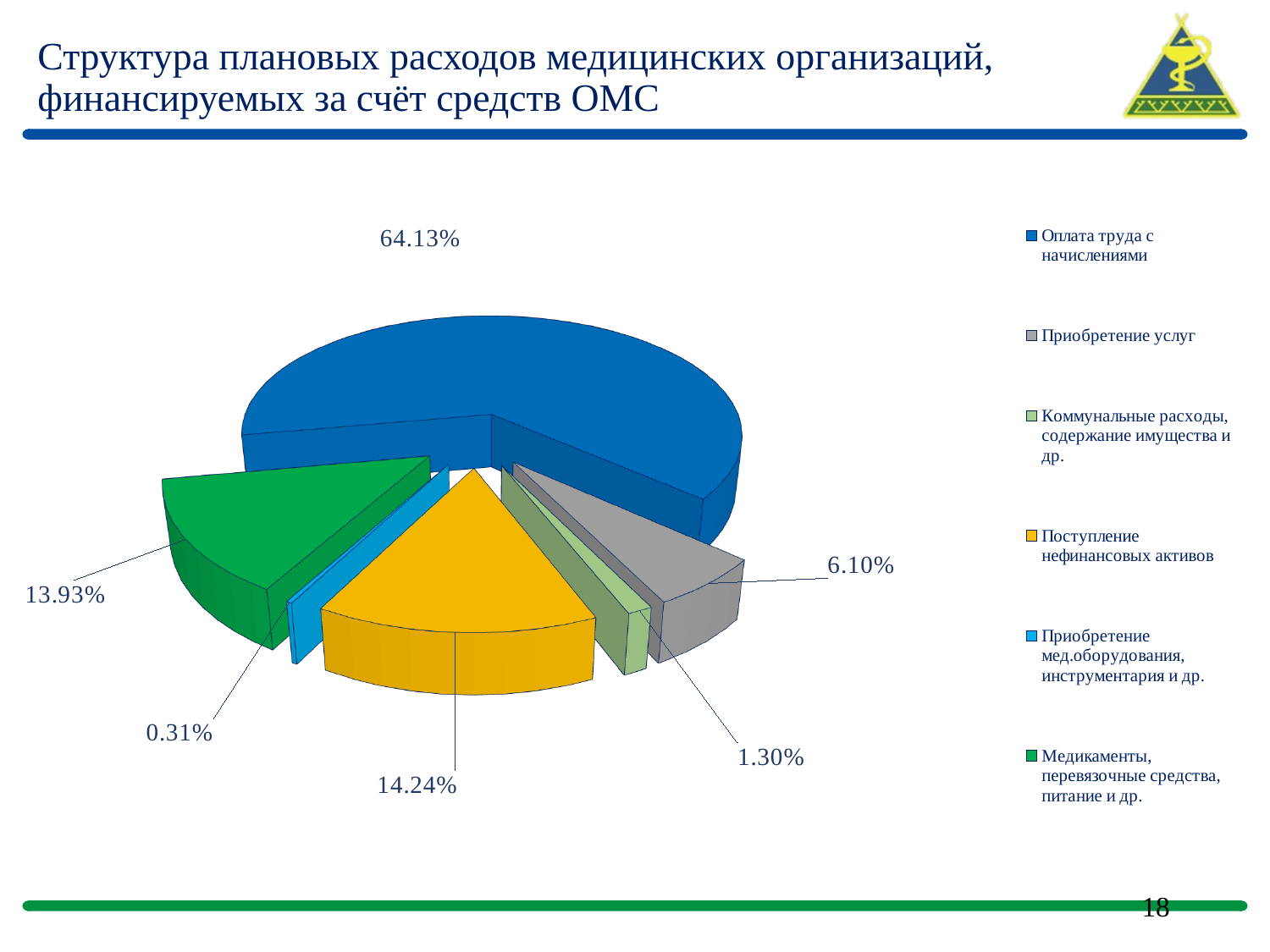
What is the value shown for "Поступление нефинансовых активов"? 14.24% What is the value shown for "Приобретение услуг"? 6.10% What type of chart is shown on the slide? Pie chart Which is larger: "Поступление нефинансовых активов" or "Приобретение услуг"? Поступление нефинансовых активов What share of the pie does "Оплата труда с начислениями" have? 64.13% How many categories does the legend of the pie chart list? 6 What is the value shown for "Приобретение мед.оборудования, инструментария и др."? 0.31% Which category has the smallest share of the pie? Приобретение мед.оборудования, инструментария и др. What colour is the slice for "Коммунальные расходы, содержание имущества и др."? Light green Which category has the largest share of the pie? Оплата труда с начислениями What is the difference between the shares of "Поступление нефинансовых активов" and "Медикаменты, перевязочные средства, питание и др."? 0.31% What is the value shown for "Медикаменты, перевязочные средства, питание и др."? 13.93%